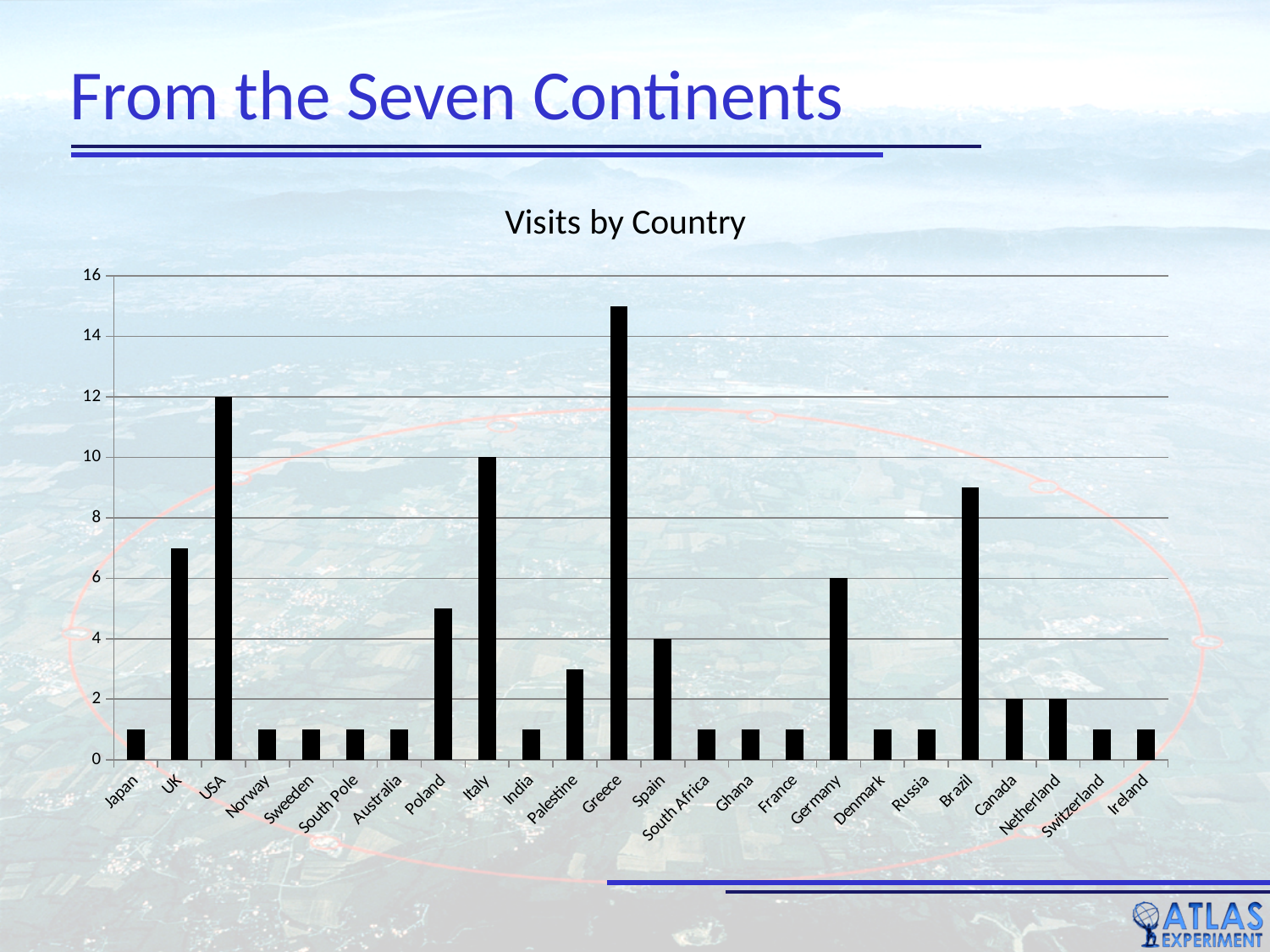
What type of chart is shown on the slide? bar chart What is the value for Germany? 6 Is the value for Greece greater or less than 14? greater Is the value for Palestine greater or less than 4? less What is the value for Italy? 10 Is the value for Brazil greater or less than 8? greater What is the value for USA? 12 How many countries are shown on the x axis of the chart? 24 Which has a larger value, Germany or Spain? Germany What is the difference between the values for USA and Italy? 2 Which country has the highest number of visits? Greece What is the title of the chart? Visits by Country